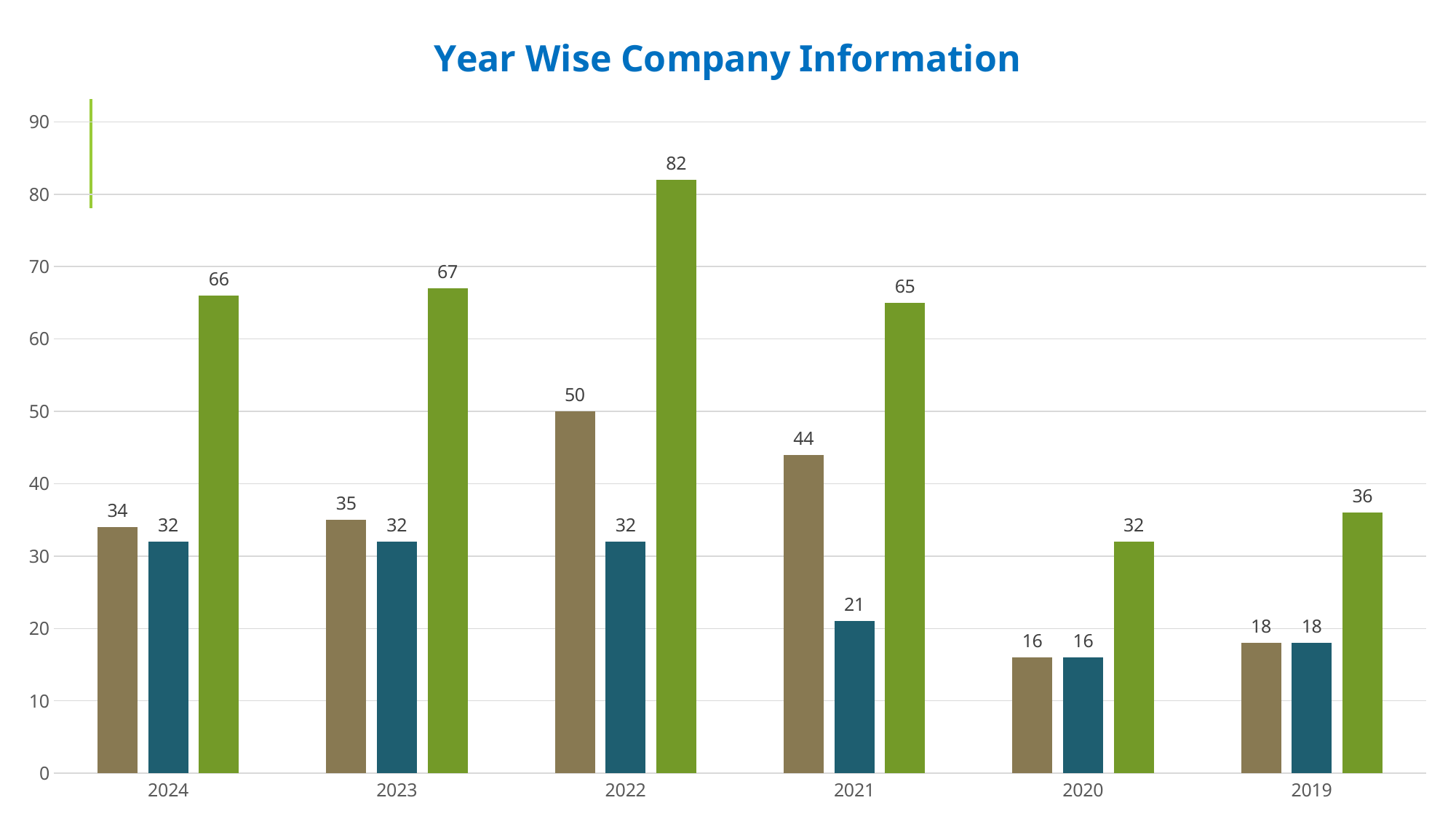
Which year has the highest green bar? 2022 What is the value of the teal bar for 2023? 32 What is the value of the green bar for 2022? 82 Is the green bar for 2019 greater or less than 40? less What type of chart is shown on the slide? bar chart What is the title of the chart? Year Wise Company Information What is the difference between the green bar and the brown bar for 2022? 32 What is the value of the brown bar for 2021? 44 How many years are shown on the x axis of the chart? 6 Which year has the lowest brown bar? 2020 Which is larger for 2021, the brown bar or the teal bar? the brown bar How many bars are shown for each year? 3